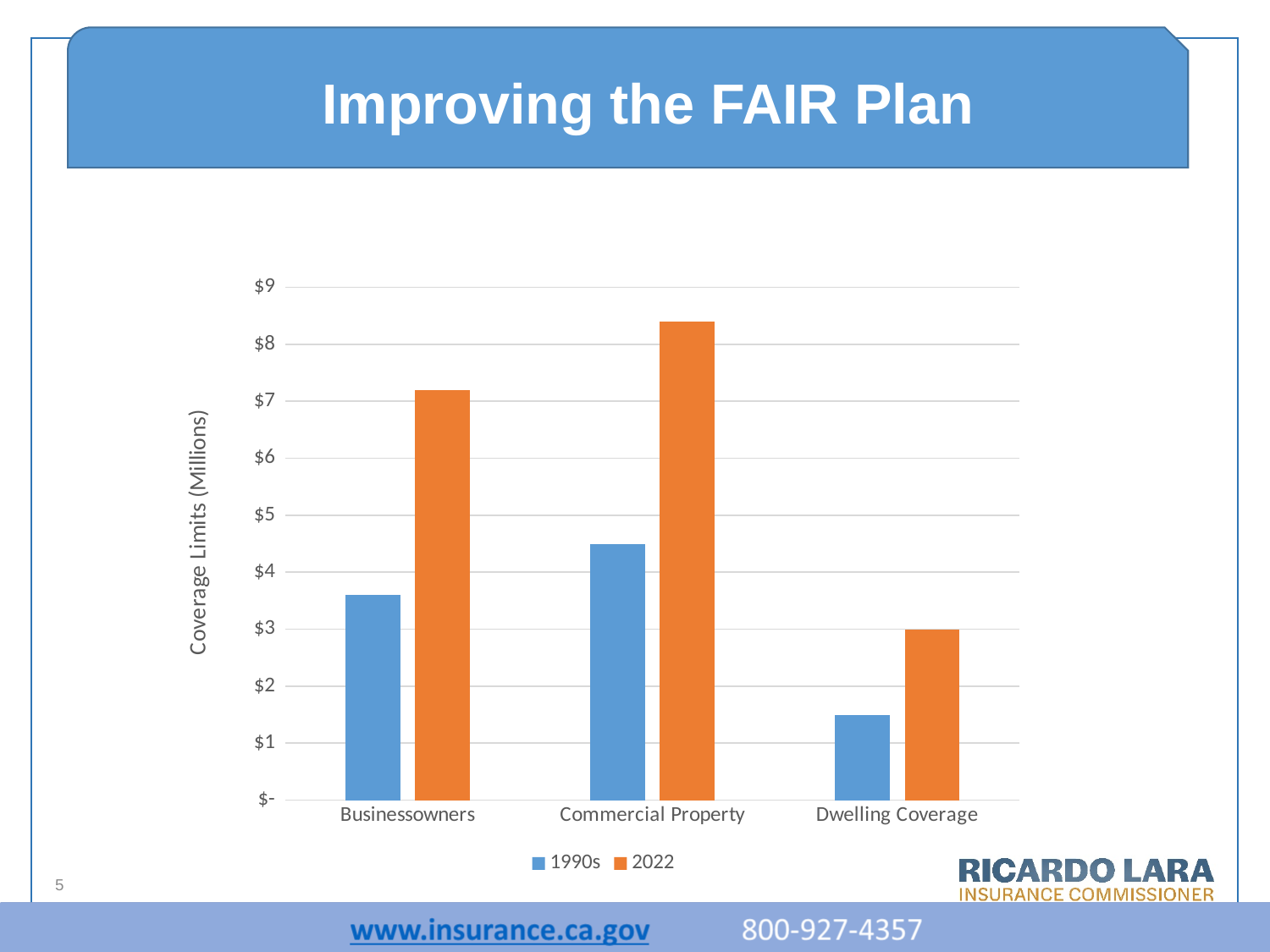
Which category has the highest 2022 coverage limit? Commercial Property What is the label on the chart's vertical axis? Coverage Limits (Millions) Is the 2022 value for Businessowners greater or less than $7 million? greater Is the 2022 value for Commercial Property greater or less than $8 million? greater What kind of chart is shown on the slide? bar chart How many categories are shown on the x axis of the chart? 3 For Commercial Property, which series has the larger value, 1990s or 2022? 2022 Which is larger: the 1990s value for Commercial Property or the 2022 value for Dwelling Coverage? 1990s value for Commercial Property Is the 1990s value for Businessowners greater or less than $4 million? less How many series does the chart's legend list? 2 Which category has the lowest 1990s coverage limit? Dwelling Coverage